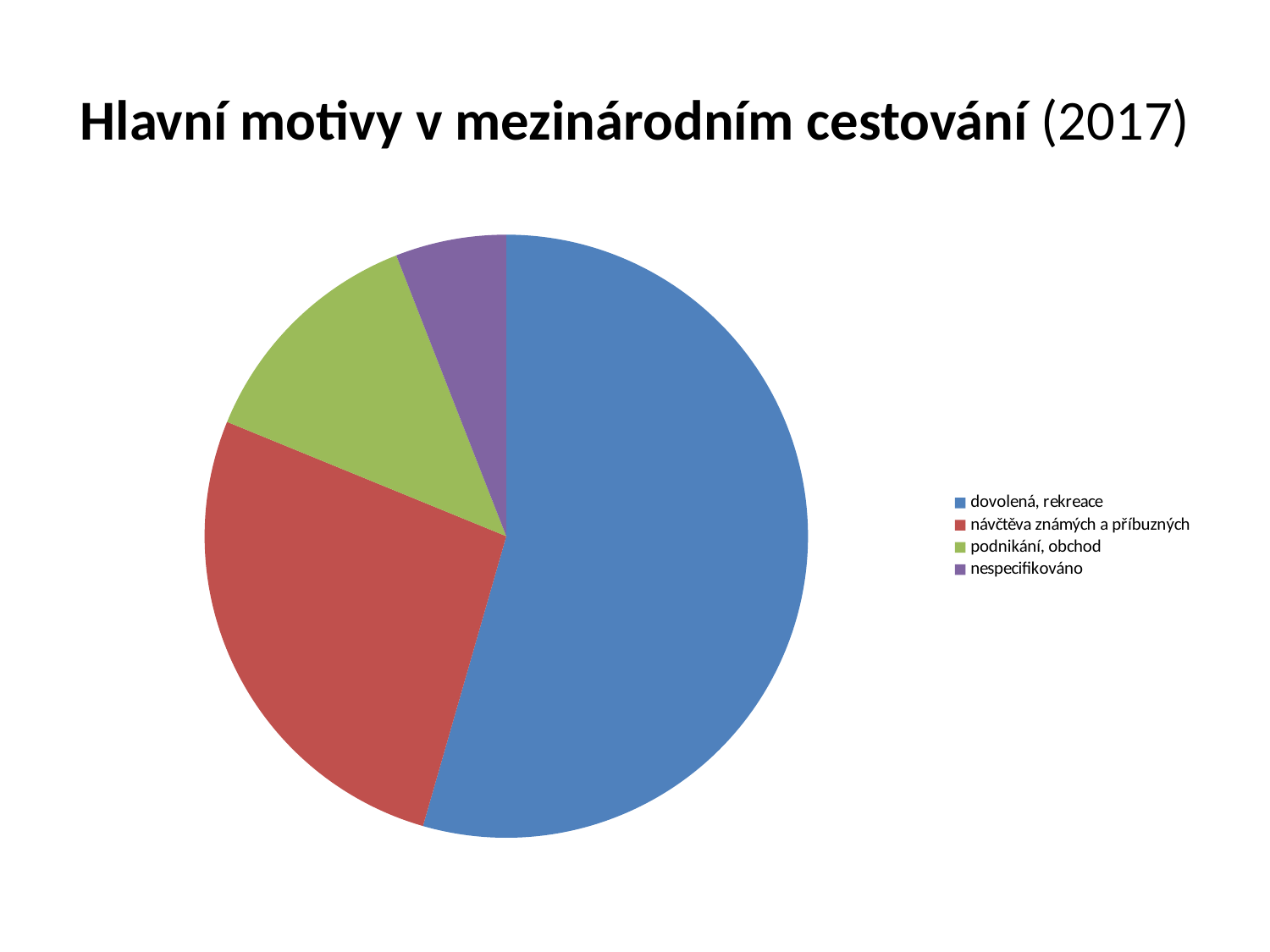
Which slice is larger: podnikání, obchod or nespecifikováno? podnikání, obchod Which category has the smallest slice of the pie? nespecifikováno What colour is the slice for podnikání, obchod? green Which slice is larger: návčtěva známých a příbuzných or podnikání, obchod? návčtěva známých a příbuzných Which category has the largest slice of the pie? dovolená, rekreace What kind of chart is shown on the slide? pie chart Which category is the second largest slice of the pie? návčtěva známých a příbuzných Does the slice for dovolená, rekreace take up more or less than half of the pie? more What is the title of the slide's chart? Hlavní motivy v mezinárodním cestování (2017) How many slices does the pie chart have? 4